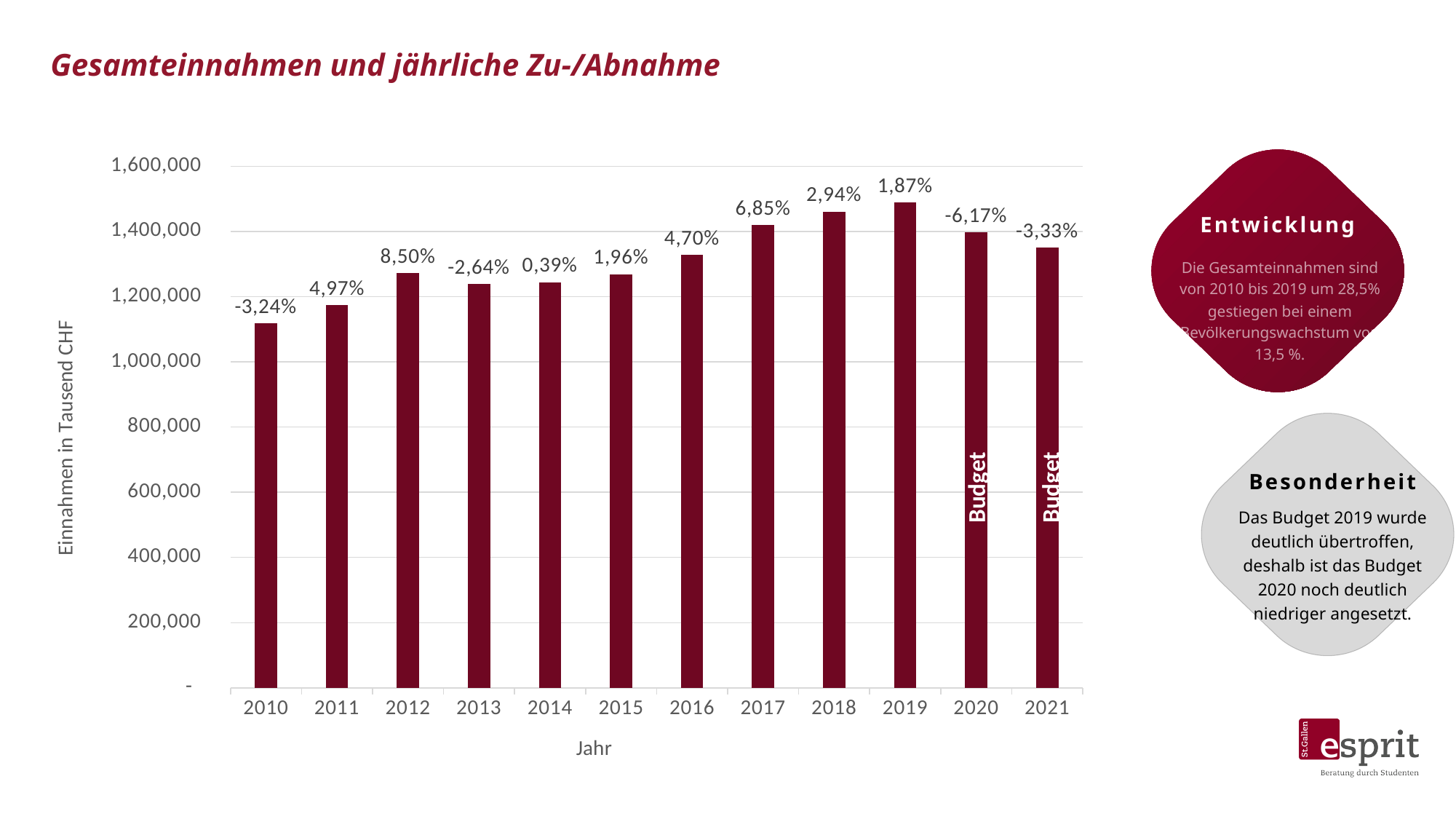
Is the value for 2010 greater or less than 1,200,000? less What percentage change is labelled above the bar for 2017? 6,85% What percentage change is labelled above the bar for 2012? 8,50% Which years' bars are labelled 'Budget'? 2020 and 2021 Is the value for 2019 greater or less than 1,400,000? greater Which year has the lowest bar in the chart? 2010 What kind of chart is shown on the slide? bar chart Do the bars rise or fall from 2014 to 2019? rise Which bar is taller, 2013 or 2017? 2017 How many years are shown on the x axis of the chart? 12 What percentage change is labelled above the bar for 2020? -6,17% Which year has the highest bar in the chart? 2019